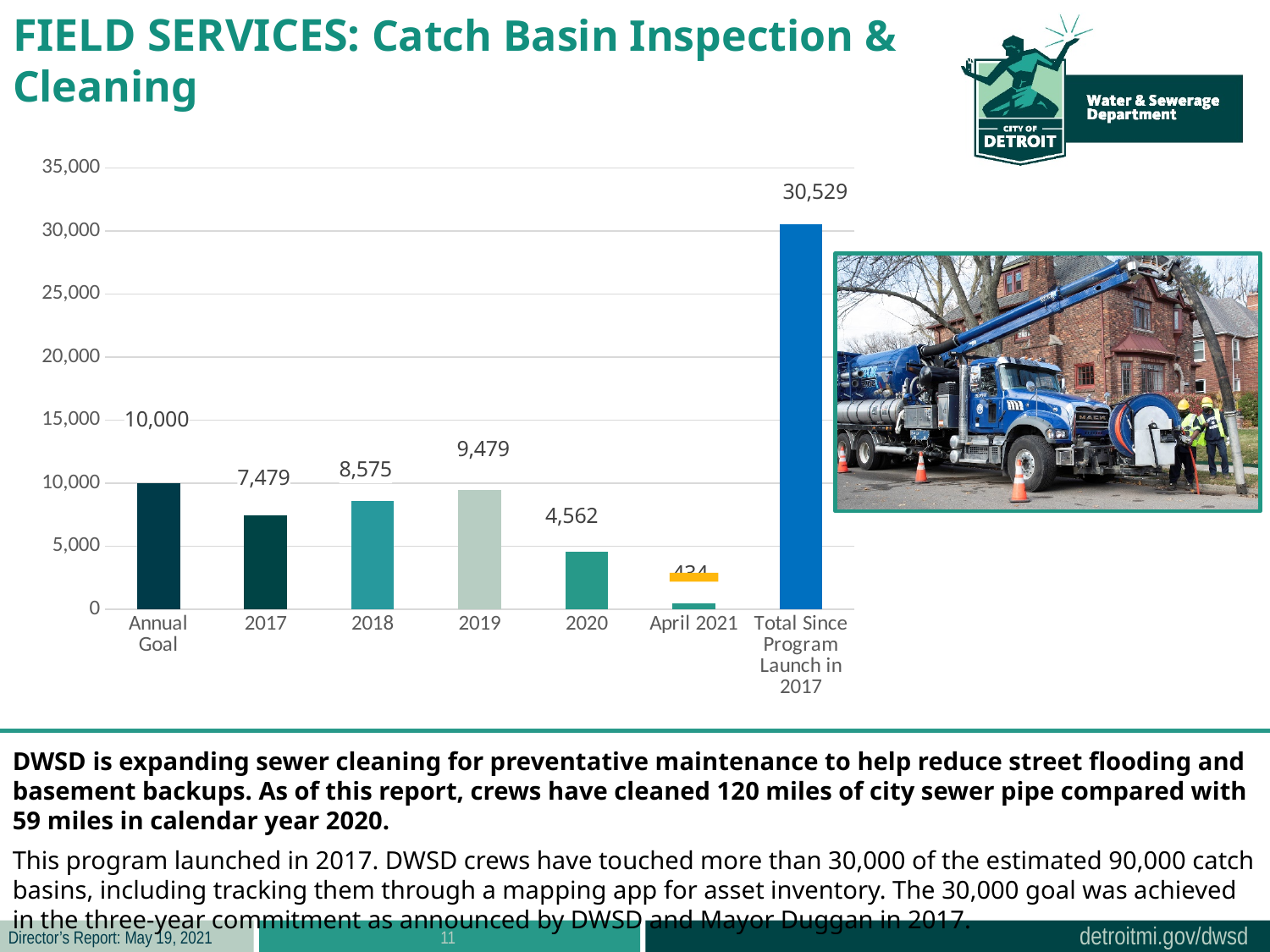
Which is larger, the value for 2017 or the value for 2018? 2018 Which category has the lowest value? April 2021 What value is shown for 2019? 9,479 What is the value of the Annual Goal bar? 10,000 Do the values rise or fall from 2017 to 2019? rise What kind of chart is shown on the slide? bar chart What value is shown for 2020? 4,562 How many categories are shown on the x axis? 7 Is the value for April 2021 greater or less than 5,000? less Which category has the highest value? Total Since Program Launch in 2017 What is the difference between the 2019 value and the 2018 value? 904 What value is shown for the Total Since Program Launch in 2017 bar? 30,529